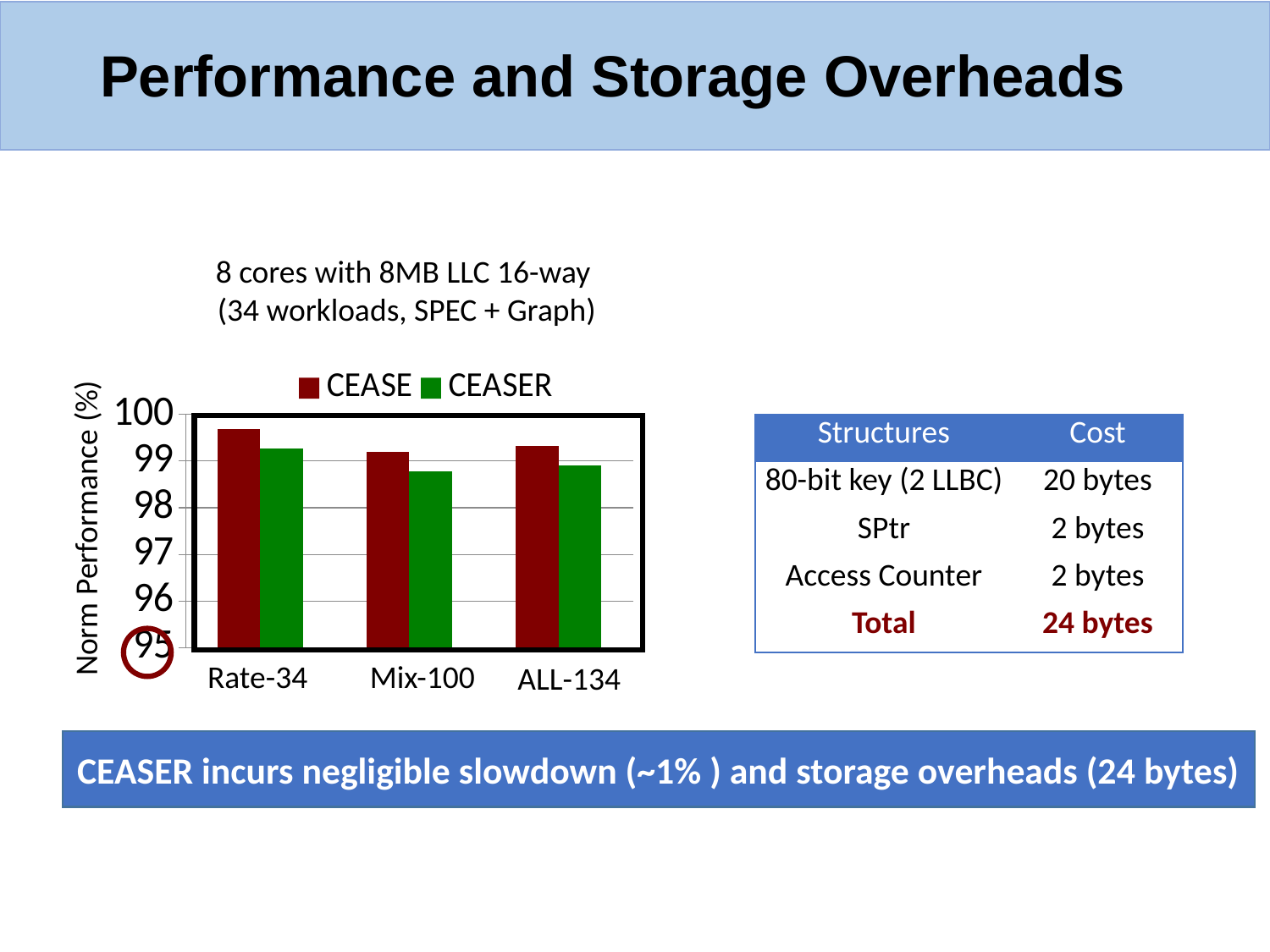
What kind of chart is shown on the slide? bar chart What colour represents the CEASER series in the chart? green Is the CEASER value for Mix-100 greater or less than 99? less How many series does the chart legend list? 2 Which series has the higher value for Mix-100, CEASE or CEASER? CEASE How many categories are shown on the x axis of the chart? 3 What is the label of the y axis of the chart? Norm Performance (%) Which series has the higher value for ALL-134, CEASE or CEASER? CEASE Is the CEASE value for Rate-34 greater or less than 99? greater Which category has the highest CEASE value? Rate-34 Which series has the higher value for Rate-34, CEASE or CEASER? CEASE Is the CEASER value for Rate-34 greater or less than 99? greater